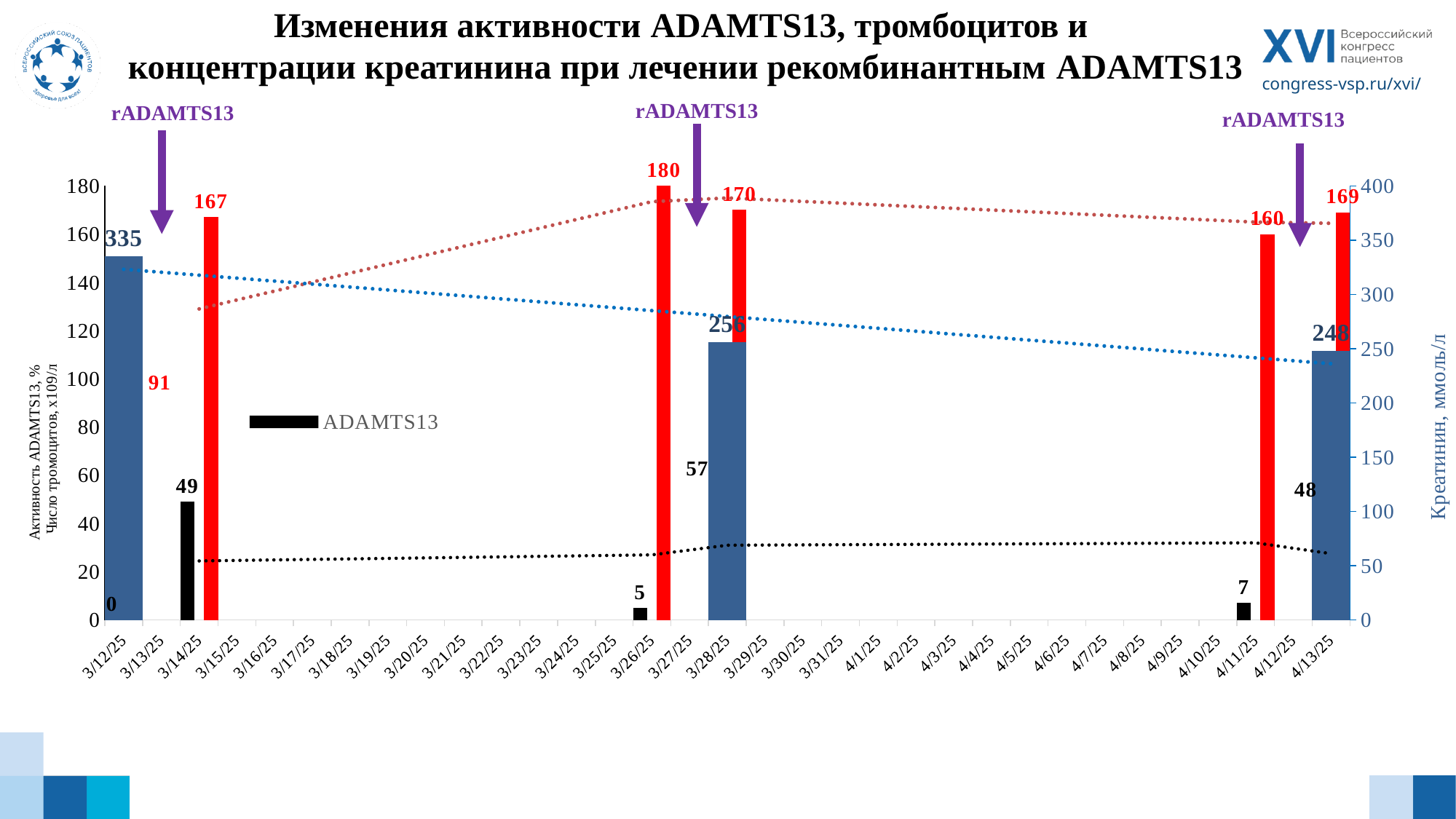
What is the value labelled on the red bar at 3/26/25? 180 Which date has the highest labelled red bar? 3/26/25 What kind of chart is shown on the slide? bar chart What is the value labelled on the black bar at 3/14/25? 49 Do the blue bar values rise or fall from 3/12/25 to 4/13/25? fall How many blue bars are plotted on the chart? 3 Which date has the lowest labelled blue bar? 4/13/25 What is the label of the right-hand vertical axis? Креатинин, ммоль/л What is the difference between the blue bar values at 3/12/25 (335) and 4/13/25 (248)? 87 What is the value labelled on the blue bar at 3/12/25? 335 What is the value labelled on the black bar at 4/11/25? 7